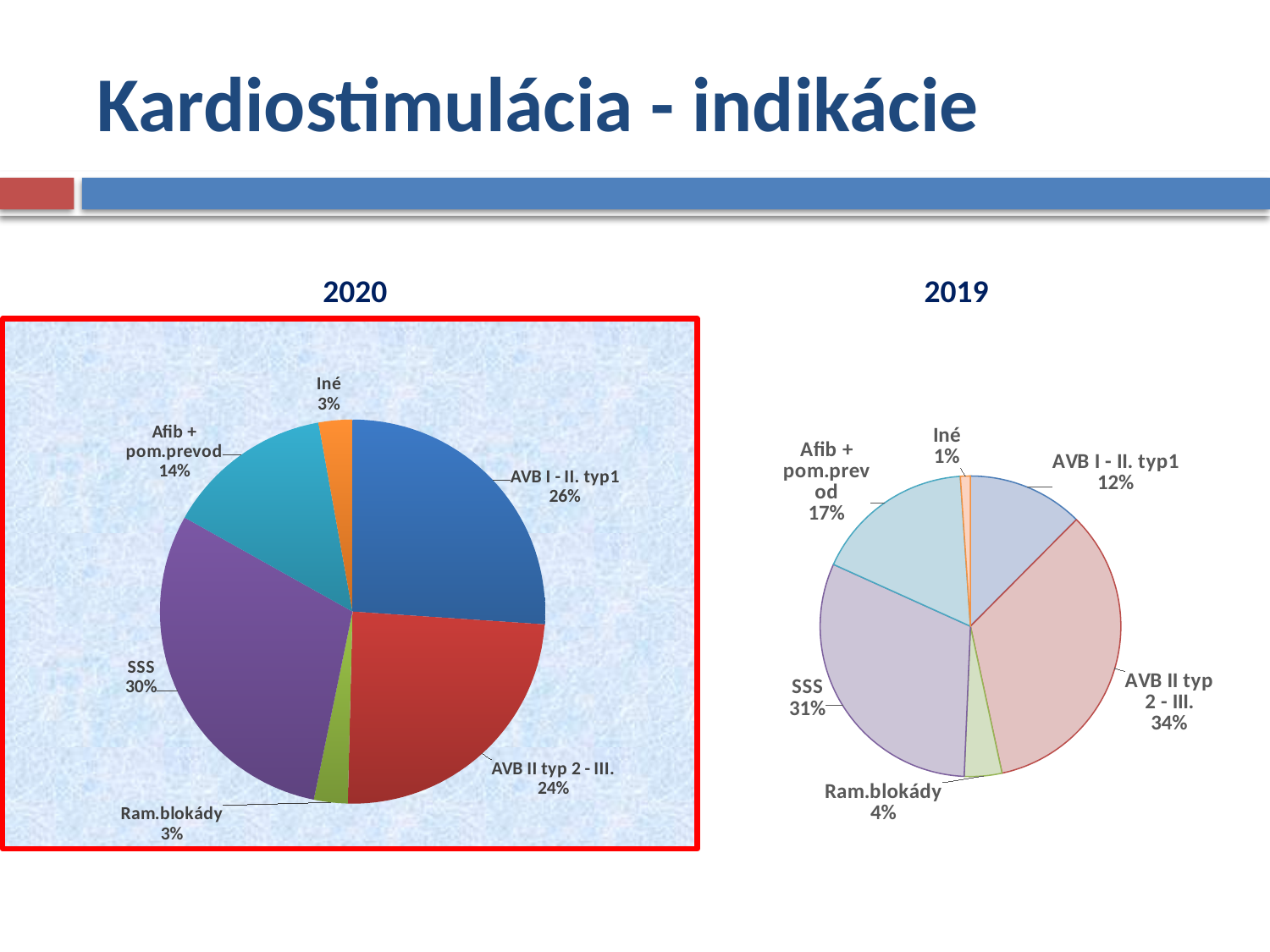
In the 2019 pie chart, which is larger: the share of SSS or the share of Afib + pom.prevod? SSS In the 2019 pie chart, which category has the smallest share? Iné How many categories does the 2020 pie chart show? 6 In the 2019 pie chart, which category has the largest share? AVB II typ 2 - III. In the 2019 pie chart, what share does AVB II typ 2 - III. have? 34% In the 2020 pie chart, what share does Afib + pom.prevod have? 14% In the 2019 pie chart, what share does Iné have? 1% In the 2020 pie chart, what share does SSS have? 30% What type of chart is used for the 2019 data? Pie chart What is the title of the slide? Kardiostimulácia - indikácie In the 2020 pie chart, which category has the largest share? SSS In the 2020 pie chart, what is the difference between the shares of SSS and AVB II typ 2 - III.? 6%